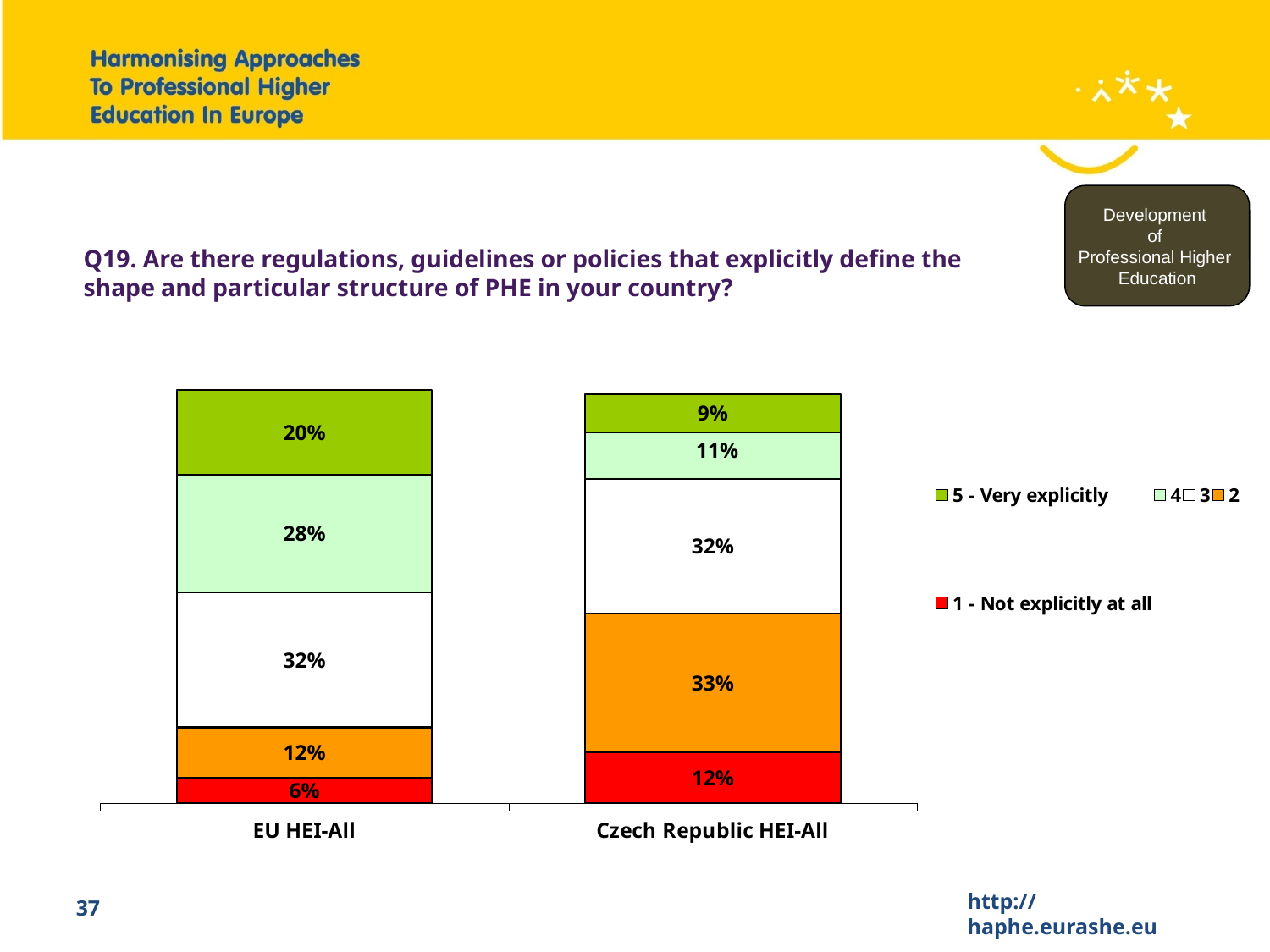
How many categories (bars) are shown on the x axis? 2 What colour is the '1 - Not explicitly at all' series in the legend? Red What is the value of the '2' segment for Czech Republic HEI-All? 33% What is the value of the '5 - Very explicitly' segment for EU HEI-All? 20% Which has a larger '2' segment, EU HEI-All or Czech Republic HEI-All? Czech Republic HEI-All Which segment is the largest in the Czech Republic HEI-All bar? 2 What is the difference between the '5 - Very explicitly' values for EU HEI-All and Czech Republic HEI-All? 11% What is the value of the '4' segment for EU HEI-All? 28% How many series does the legend list? 5 Which segment is the smallest in the EU HEI-All bar? 1 - Not explicitly at all What kind of chart is shown on the slide? Stacked bar chart What is the value of the '1 - Not explicitly at all' segment for Czech Republic HEI-All? 12%